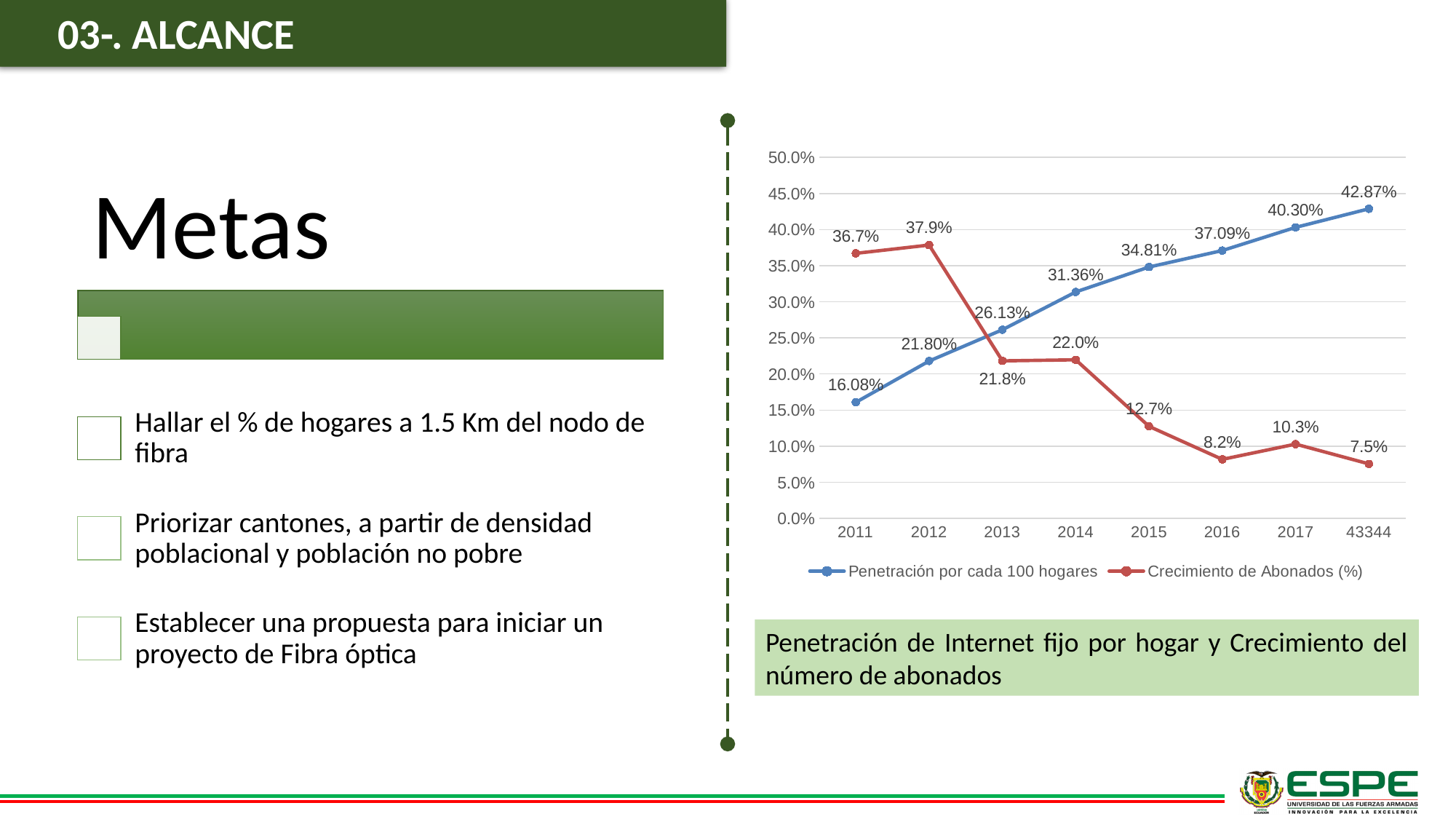
What is the difference between Penetración por cada 100 hogares and Crecimiento de Abonados (%) in 2016? 28.89% Does Penetración por cada 100 hogares rise or fall from 2011 to the last category? Rise What kind of chart is shown on the slide? Line chart What is the highest value shown for Penetración por cada 100 hogares? 42.87% In which year does Crecimiento de Abonados (%) reach its highest value? 2012 What is the value of Crecimiento de Abonados (%) in 2014? 22.0% What is the lowest value shown for Crecimiento de Abonados (%)? 7.5% How many data points does each series have on the chart? 8 What is the value of Penetración por cada 100 hogares in 2011? 16.08% In 2013, which series has the larger value: Penetración por cada 100 hogares or Crecimiento de Abonados (%)? Penetración por cada 100 hogares How many series does the legend list? 2 What is the value of Penetración por cada 100 hogares in 2016? 37.09%